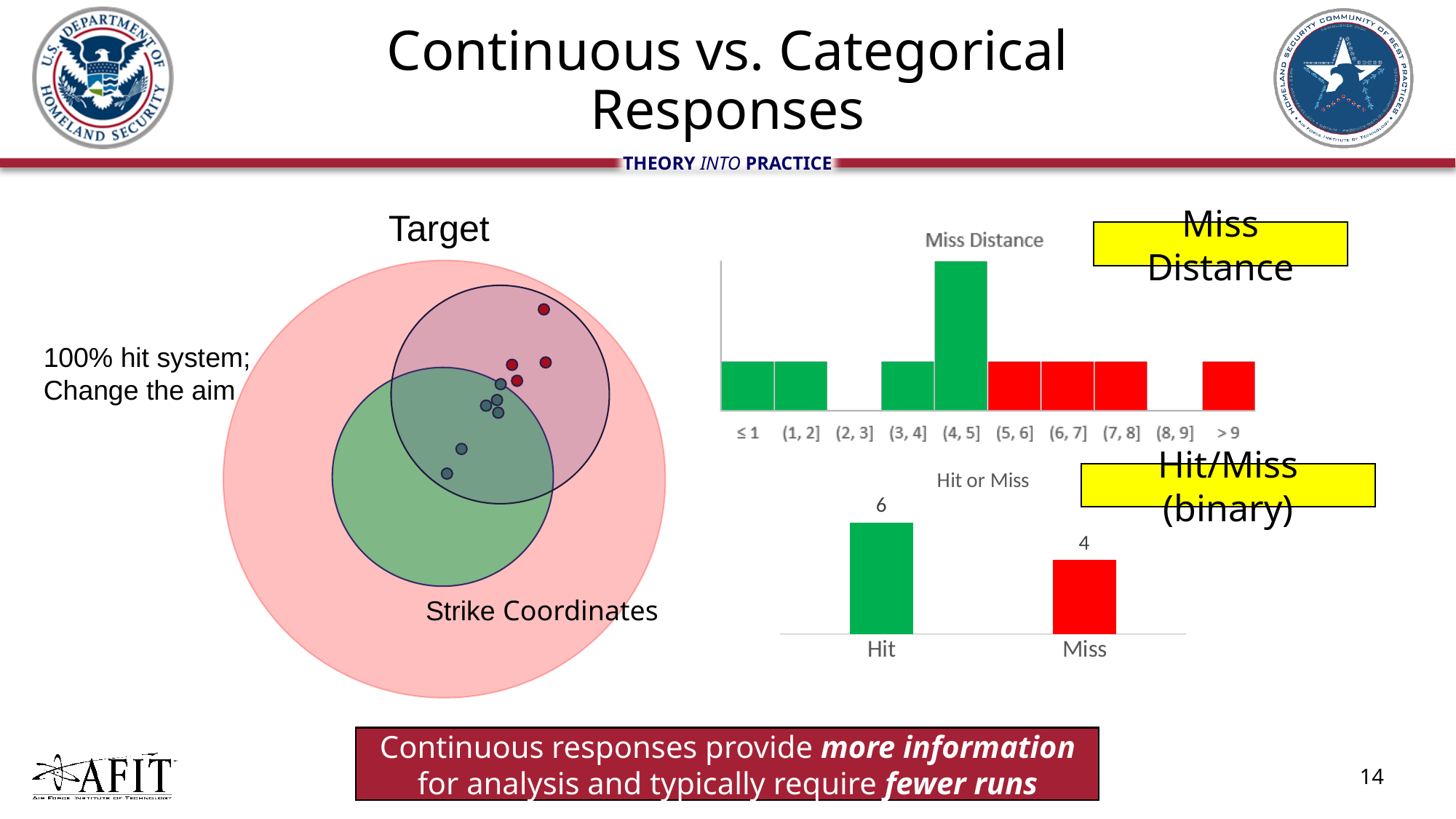
How many bins are labelled on the x axis of the Miss Distance chart? 10 How many categories are shown in the Hit or Miss chart? 2 In the Hit or Miss chart, what is the difference between the Hit and Miss values? 2 In the Miss Distance chart, which two bins have no bar? (2, 3] and (8, 9] In the Hit or Miss chart, which category has the lower value? Miss In the Miss Distance chart, what colour are the bars for bins (5, 6] and above? Red In the Miss Distance chart, which bin has the tallest bar? (4, 5] In the Hit or Miss chart, what is the value for Miss? 4 In the Hit or Miss chart, which category has the higher value? Hit What kind of chart is the Hit or Miss chart? Bar chart In the Hit or Miss chart, what is the total of the Hit and Miss values? 10 In the Hit or Miss chart, what is the value for Hit? 6